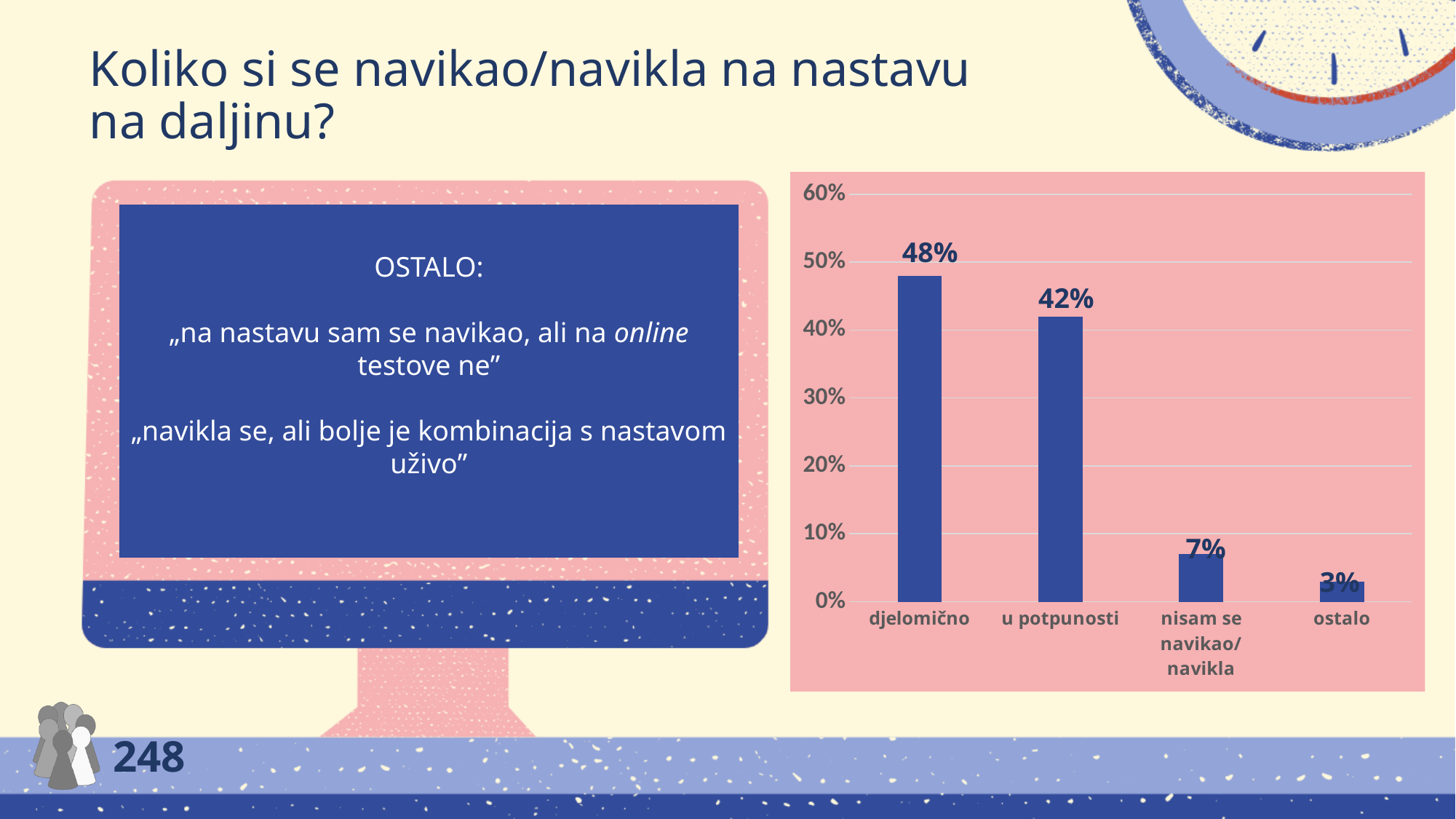
Which category has the highest value? djelomično What is the highest value shown on the chart's vertical axis? 60% How many categories are shown in the chart? 4 Which is larger, the value for "nisam se navikao/navikla" or the value for "ostalo"? nisam se navikao/navikla What is the value for "nisam se navikao/navikla"? 7% What is the value for "djelomično"? 48% Is the value for "u potpunosti" greater or less than 40%? greater What is the value for "ostalo"? 3% Which category has the lowest value? ostalo What is the difference between the values for "djelomično" and "u potpunosti"? 6% What kind of chart is shown on the slide? bar chart What is the value for "u potpunosti"? 42%